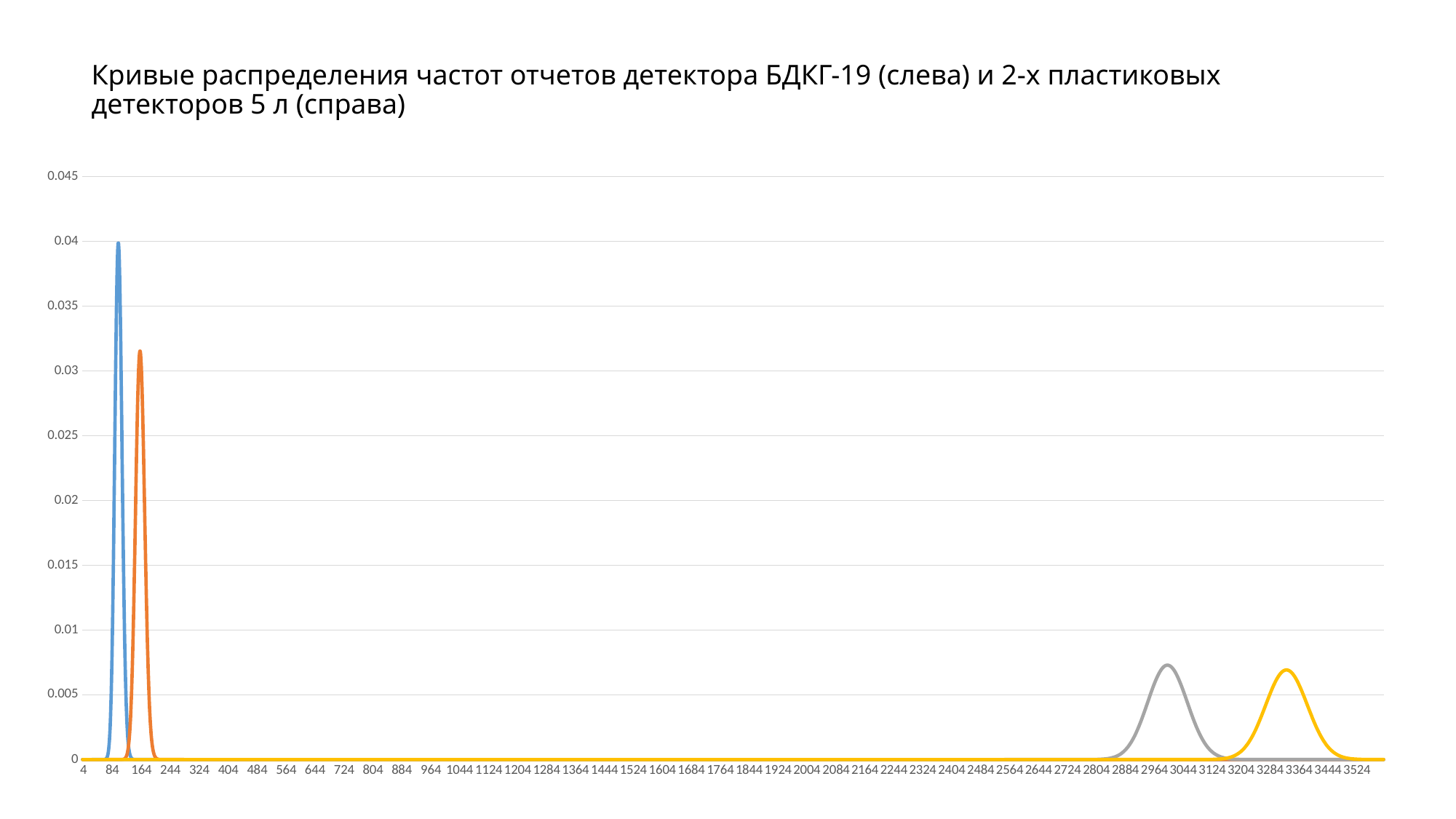
Is the peak of the orange curve greater or less than 0.035? less Is the peak of the blue curve greater or less than 0.035? greater What is the highest value shown on the y axis? 0.045 What kind of chart is shown on the slide? line chart Is the peak of the orange curve greater or less than 0.03? greater Which peak is higher, the orange curve's or the gray curve's? orange How many curves are plotted on the chart? 4 Which coloured curve peaks furthest to the right along the x axis? yellow Which peak is higher, the blue curve's or the orange curve's? blue Which coloured curve has the highest peak? blue